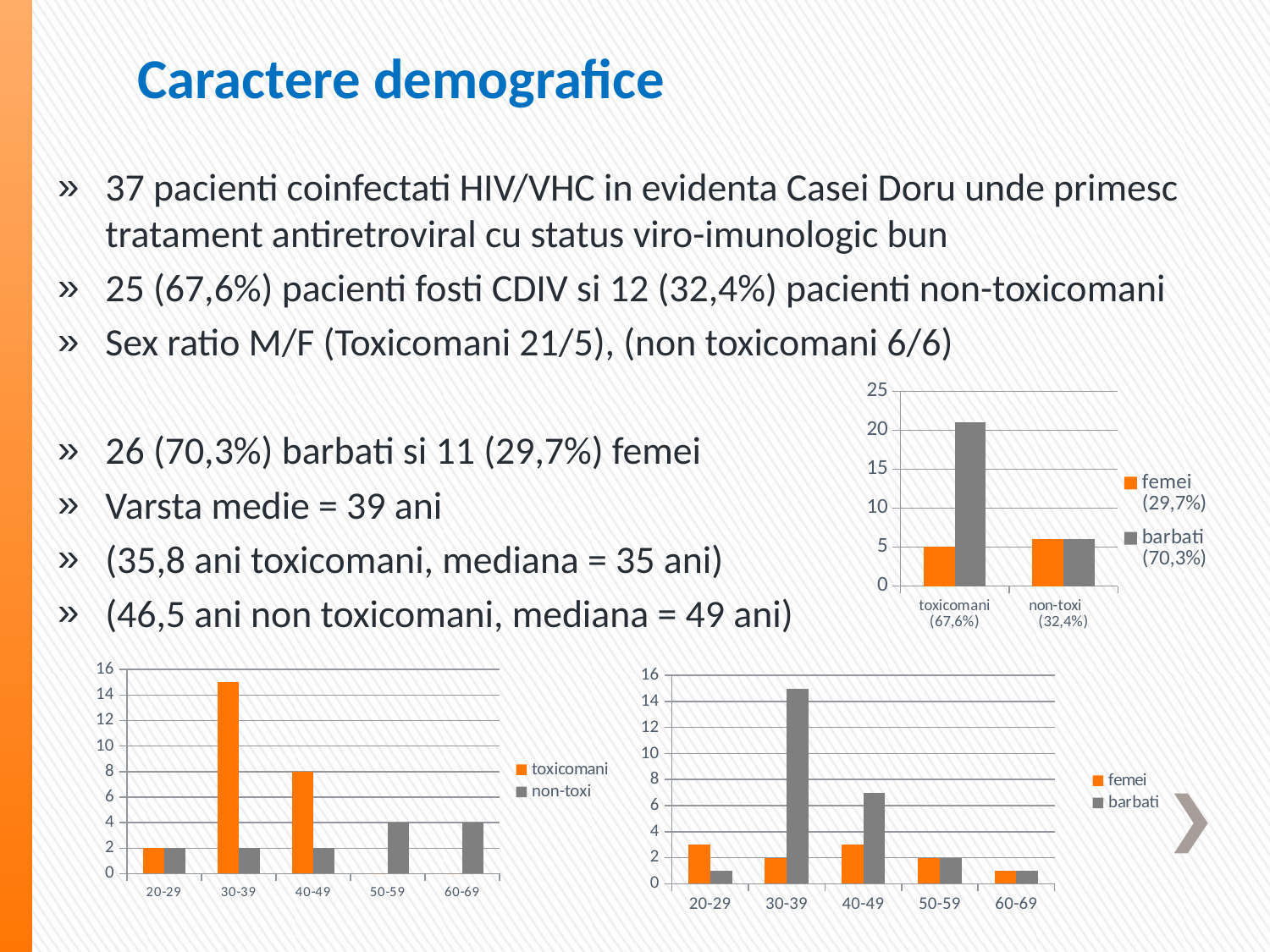
In the top-right chart, is the value for barbati in the toxicomani group greater or less than 20? greater In the bottom-right chart, which age group has the highest barbati value? 30-39 In the top-right chart, what is the value for femei in the toxicomani group? 5 What type of chart is the top-right chart on the slide? bar chart How many age-group categories are shown on the x axis of the bottom-left chart? 5 In the bottom-left chart, is the value for toxicomani in the 30-39 age group greater or less than 14? greater In the bottom-left chart, which age group has the highest toxicomani value? 30-39 In the top-right chart, which category has the tallest bar? toxicomani (67,6%) In the bottom-left chart, what is the value for toxicomani in the 40-49 age group? 8 How many series does the legend of the top-right chart list? 2 In the bottom-right chart, what is the value for femei in the 50-59 age group? 2 In the bottom-left chart, what is the value for non-toxi in the 50-59 age group? 4